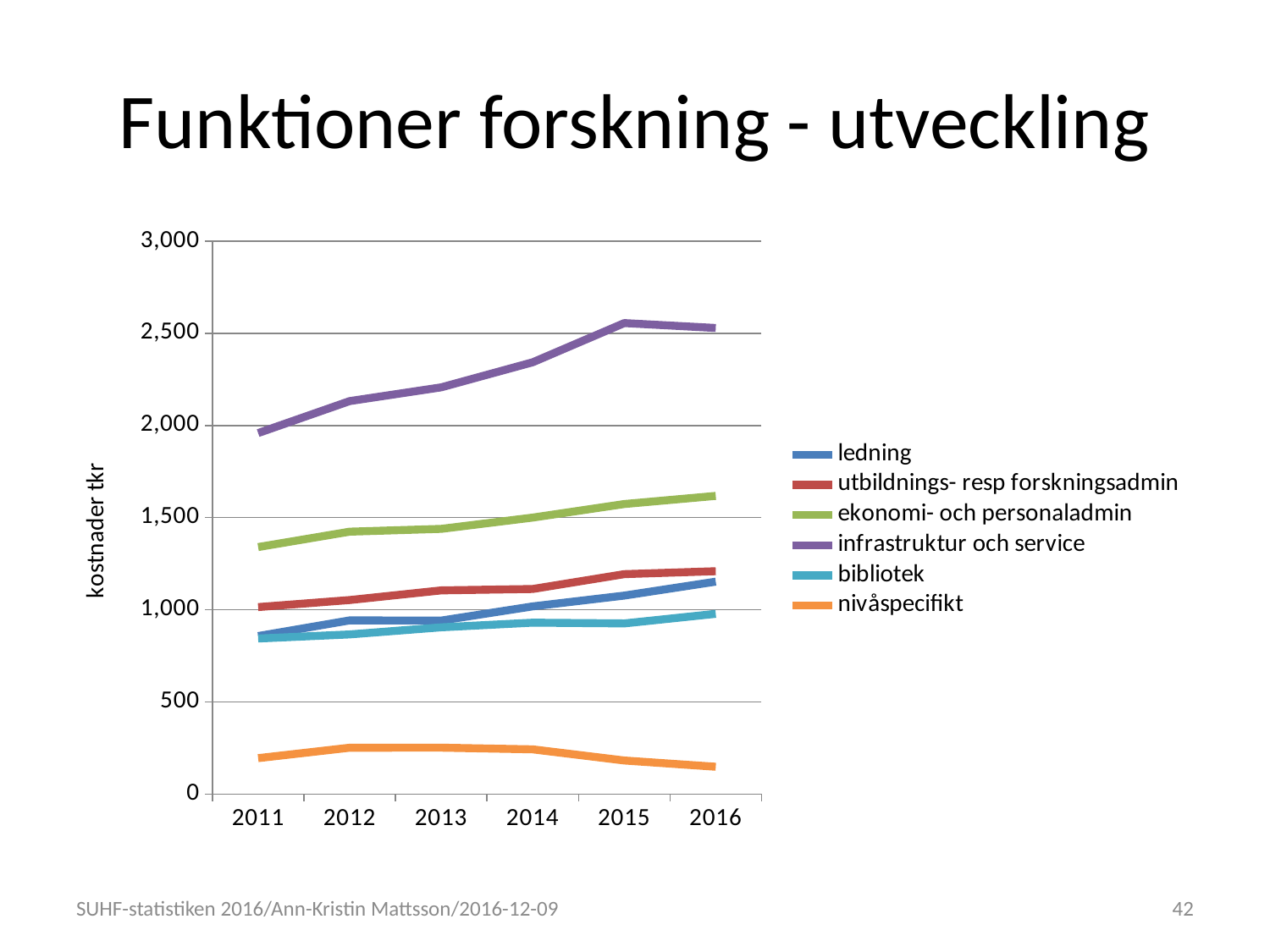
In 2016, which is larger: ledning or bibliotek? ledning Is the value for ekonomi- och personaladmin in 2016 greater or less than 1,500? greater What is the label on the y axis? kostnader tkr Does the value for nivåspecifikt rise or fall from 2012 to 2016? fall How many years are shown on the x axis? 6 Which series has the lowest value in 2016? nivåspecifikt How many series does the legend list? 6 What kind of chart is shown on the slide? line chart Is the value for infrastruktur och service in 2014 greater or less than 2,000? greater Does the value for infrastruktur och service rise or fall from 2011 to 2015? rise Is the value for nivåspecifikt in 2016 greater or less than 500? less Which series has the highest value in 2016? infrastruktur och service